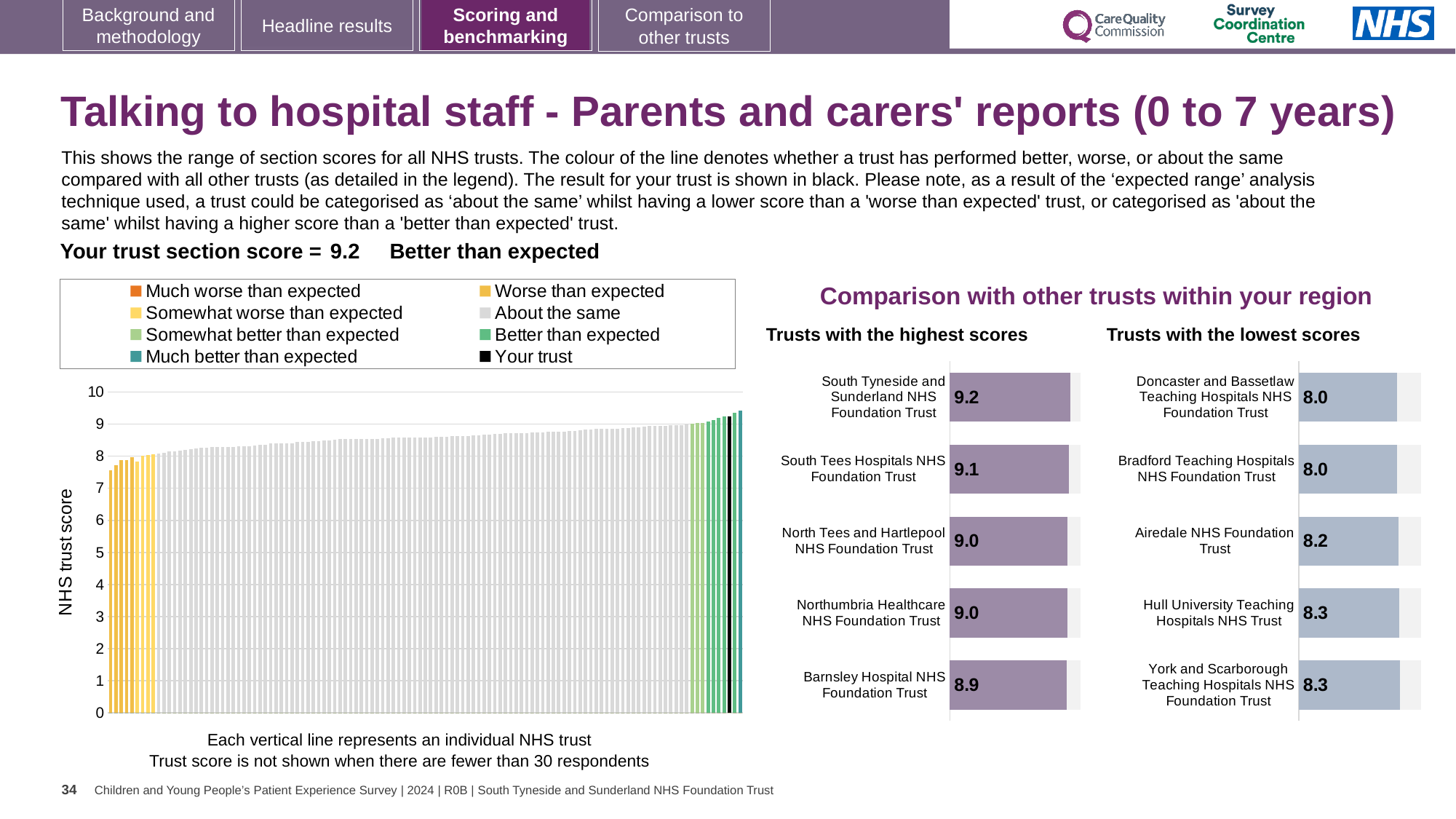
In the 'Trusts with the highest scores' chart, what is the difference between the scores of South Tyneside and Sunderland NHS Foundation Trust and Barnsley Hospital NHS Foundation Trust? 0.3 In the 'Trusts with the lowest scores' chart, what is the score for Airedale NHS Foundation Trust? 8.2 In the 'Trusts with the highest scores' chart, which trust has the highest score? South Tyneside and Sunderland NHS Foundation Trust In the large chart on the left, is the value of the black 'Your trust' bar greater or less than 9? greater In the 'Trusts with the highest scores' chart, what is the score for South Tees Hospitals NHS Foundation Trust? 9.1 In the 'Trusts with the lowest scores' chart, which has the larger score: Airedale NHS Foundation Trust or Hull University Teaching Hospitals NHS Trust? Hull University Teaching Hospitals NHS Trust How many entries does the legend of the large chart on the left list? 8 What type of chart is the large chart on the left showing NHS trust scores? Bar chart In the 'Trusts with the highest scores' chart, which trust has the lowest score? Barnsley Hospital NHS Foundation Trust In the large chart on the left, do the trust scores rise or fall from left to right? Rise How many trusts are listed in the 'Trusts with the highest scores' chart? 5 In the 'Trusts with the lowest scores' chart, what is the difference between the scores of Hull University Teaching Hospitals NHS Trust and Doncaster and Bassetlaw Teaching Hospitals NHS Foundation Trust? 0.3